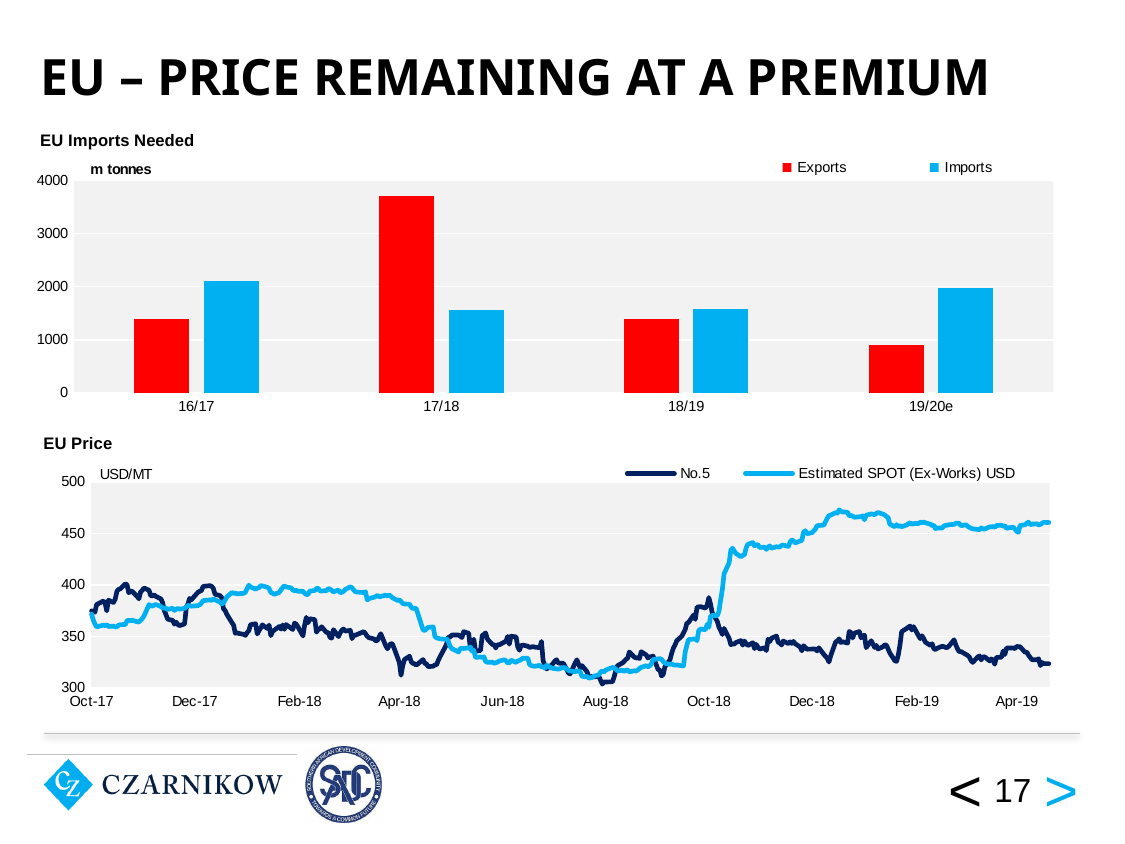
In the EU Imports Needed chart, which is larger for 17/18, Exports or Imports? Exports What type of chart is the EU Imports Needed chart? bar chart In the EU Imports Needed chart, is the Exports value for 19/20e greater or less than 1000? less How many series does the legend of the EU Price chart list? 2 In the EU Price chart, is the Estimated SPOT (Ex-Works) USD value at Apr-19 greater or less than 450? greater In the EU Price chart, which series is higher at Apr-19, No.5 or Estimated SPOT (Ex-Works) USD? Estimated SPOT (Ex-Works) USD How many seasons are shown on the x axis of the EU Imports Needed chart? 4 In the EU Imports Needed chart, is the Exports value for 17/18 greater or less than 3000? greater In the EU Imports Needed chart, which is larger for 19/20e, Exports or Imports? Imports In the EU Imports Needed chart, which season has the lowest Exports value? 19/20e In the EU Imports Needed chart, which season has the highest Exports value? 17/18